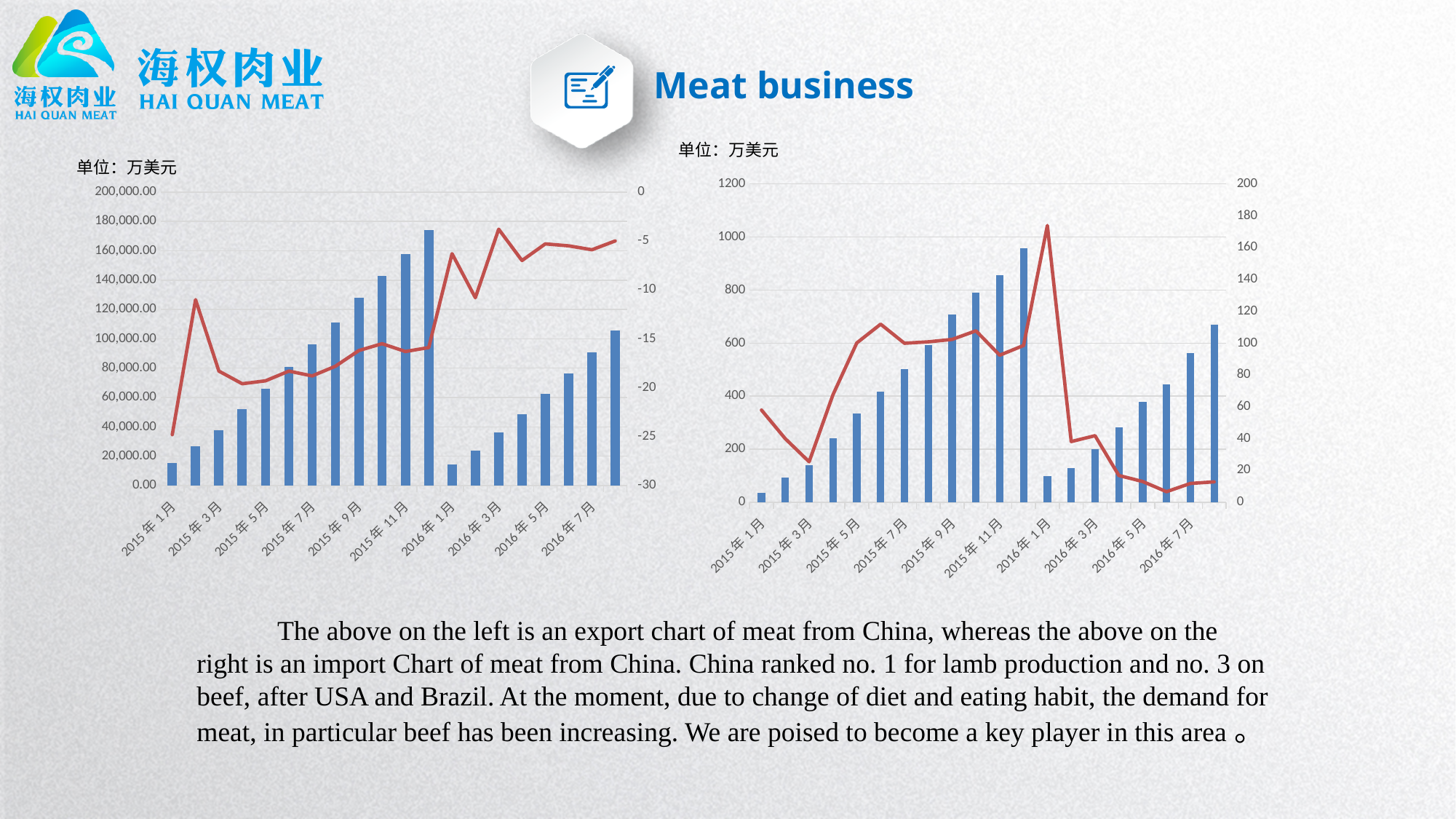
How many bars are plotted in the right chart? 20 In the right chart, which month has the tallest bar? 2015年12月 What kind of chart is the left chart on the slide? A bar chart with a line overlay In the right chart, is the bar value for 2016年1月 greater or less than 200? less In the left chart, which month has the tallest bar? 2015年12月 In the right chart, which bar is taller: 2015年9月 or 2016年7月? 2015年9月 In the left chart, is the bar value for 2015年9月 greater or less than 100,000.00? greater In the left chart, do the bars rise or fall from 2015年1月 to 2015年12月? rise In the right chart, which month has the shortest bar? 2015年1月 What unit label is shown above each chart? 单位：万美元 In the left chart, is the bar value for 2015年1月 greater or less than 20,000.00? less